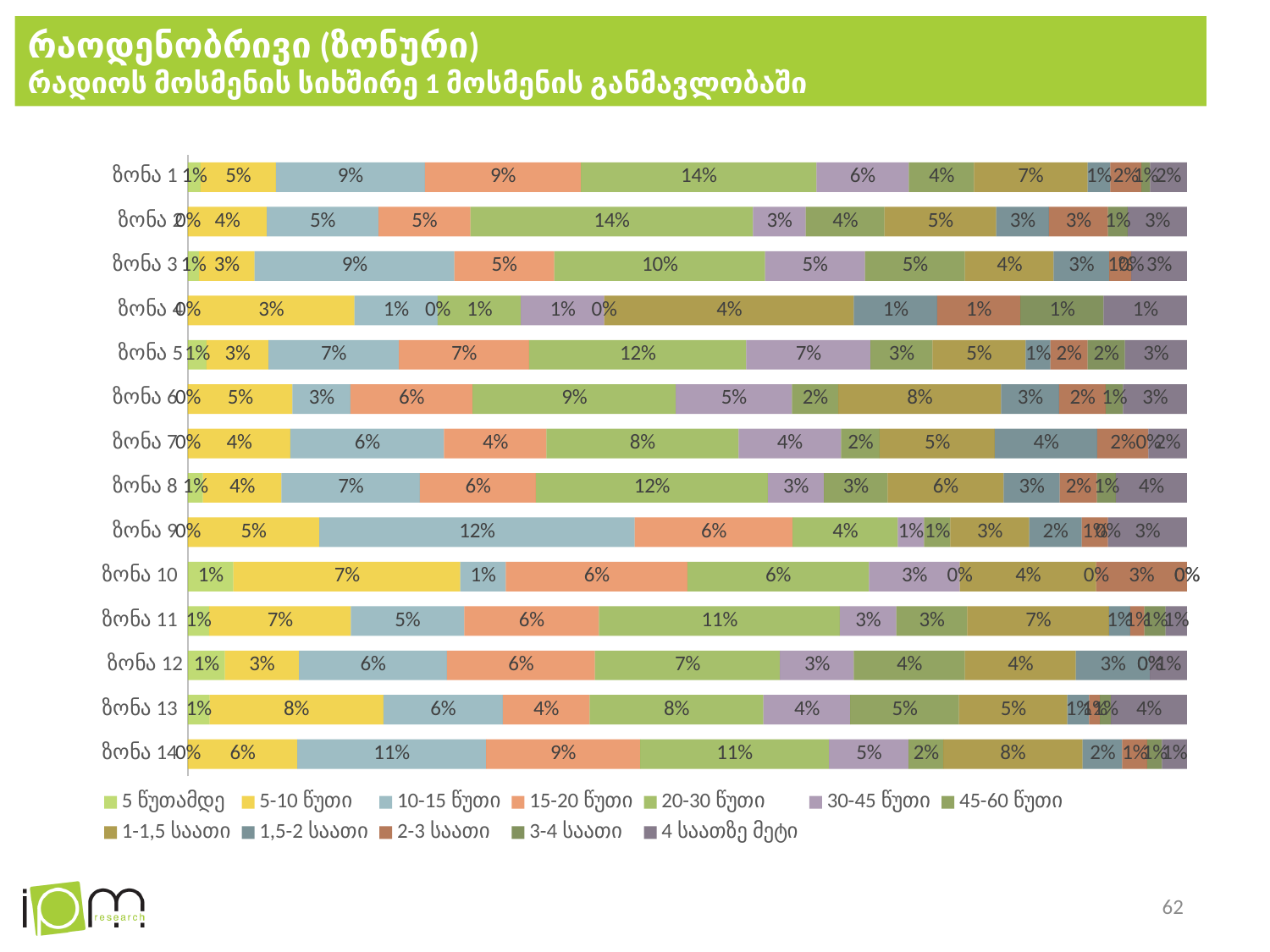
Which series has the largest segment in the ზონა 5 bar? 20-30 წუთი What is the value for 10-15 წუთი in ზონა 9? 12% How many zones (categories) are plotted on the chart? 14 What is the difference between the 20-30 წუთი value in ზონა 2 and the 20-30 წუთი value in ზონა 7? 6% What kind of chart is shown on the slide? Stacked bar chart How many series does the legend list? 12 What is the value for 10-15 წუთი in ზონა 14? 11% In ზონა 8, which is larger: the 10-15 წუთი segment or the 15-20 წუთი segment? 10-15 წუთი What is the value for 20-30 წუთი in ზონა 1? 14% What is the first series listed in the legend? 5 წუთამდე What is the value for 1-1,5 საათი in ზონა 6? 8%